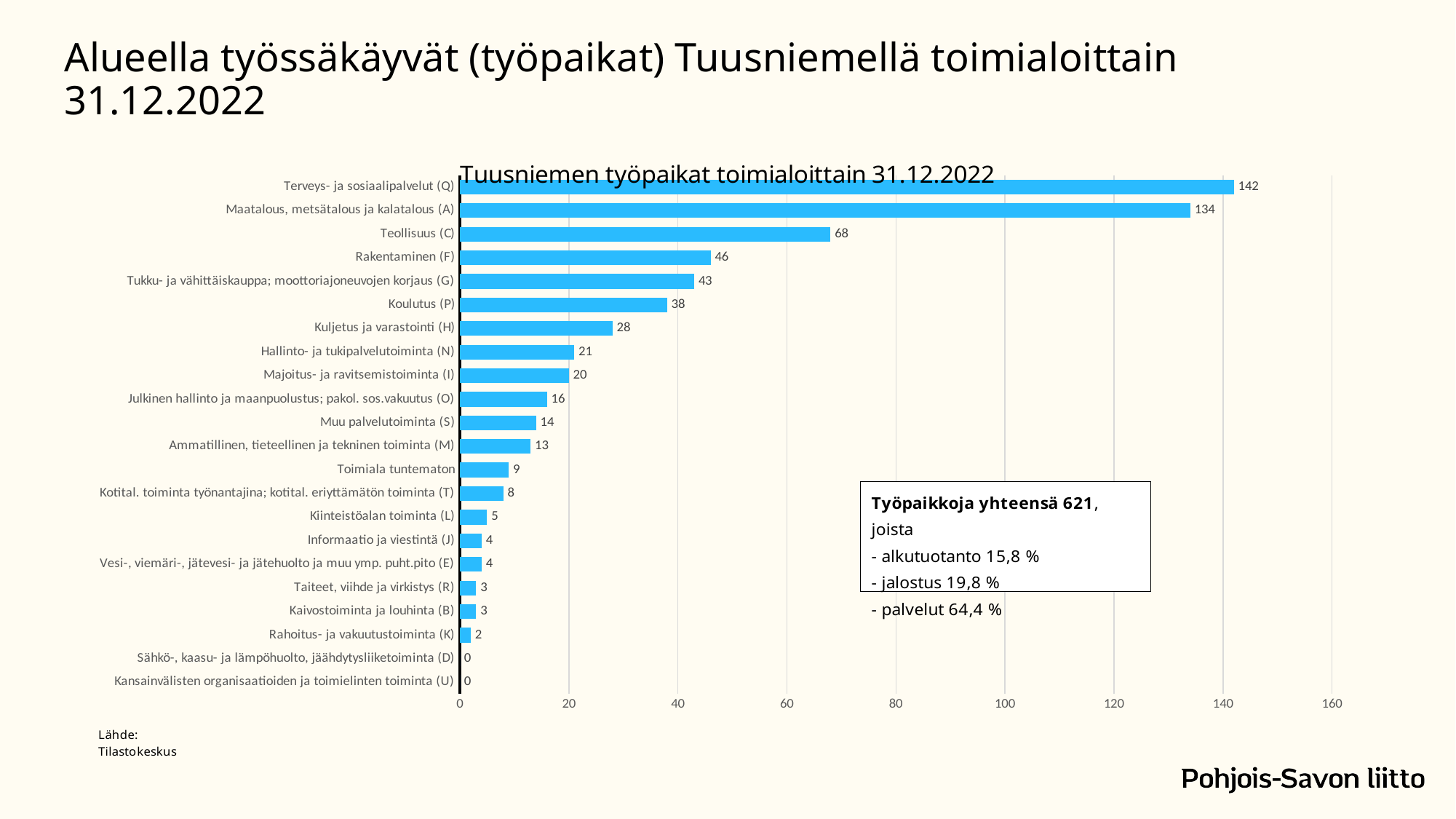
What is the value for Kuljetus ja varastointi (H)? 28 How many categories are shown on the chart? 22 Is the value for Maatalous, metsätalous ja kalatalous (A) greater or less than 120? greater What is the total number of jobs stated in the text box on the chart? 621 Which category has the highest value? Terveys- ja sosiaalipalvelut (Q) What is the value for Terveys- ja sosiaalipalvelut (Q)? 142 What kind of chart is shown? bar chart What is the value for Koulutus (P)? 38 What is the chart's title? Tuusniemen työpaikat toimialoittain 31.12.2022 What is the value for Teollisuus (C)? 68 What is the difference between Terveys- ja sosiaalipalvelut (Q) and Maatalous, metsätalous ja kalatalous (A)? 8 Which is larger, Rakentaminen (F) or Tukku- ja vähittäiskauppa; moottoriajoneuvojen korjaus (G)? Rakentaminen (F)